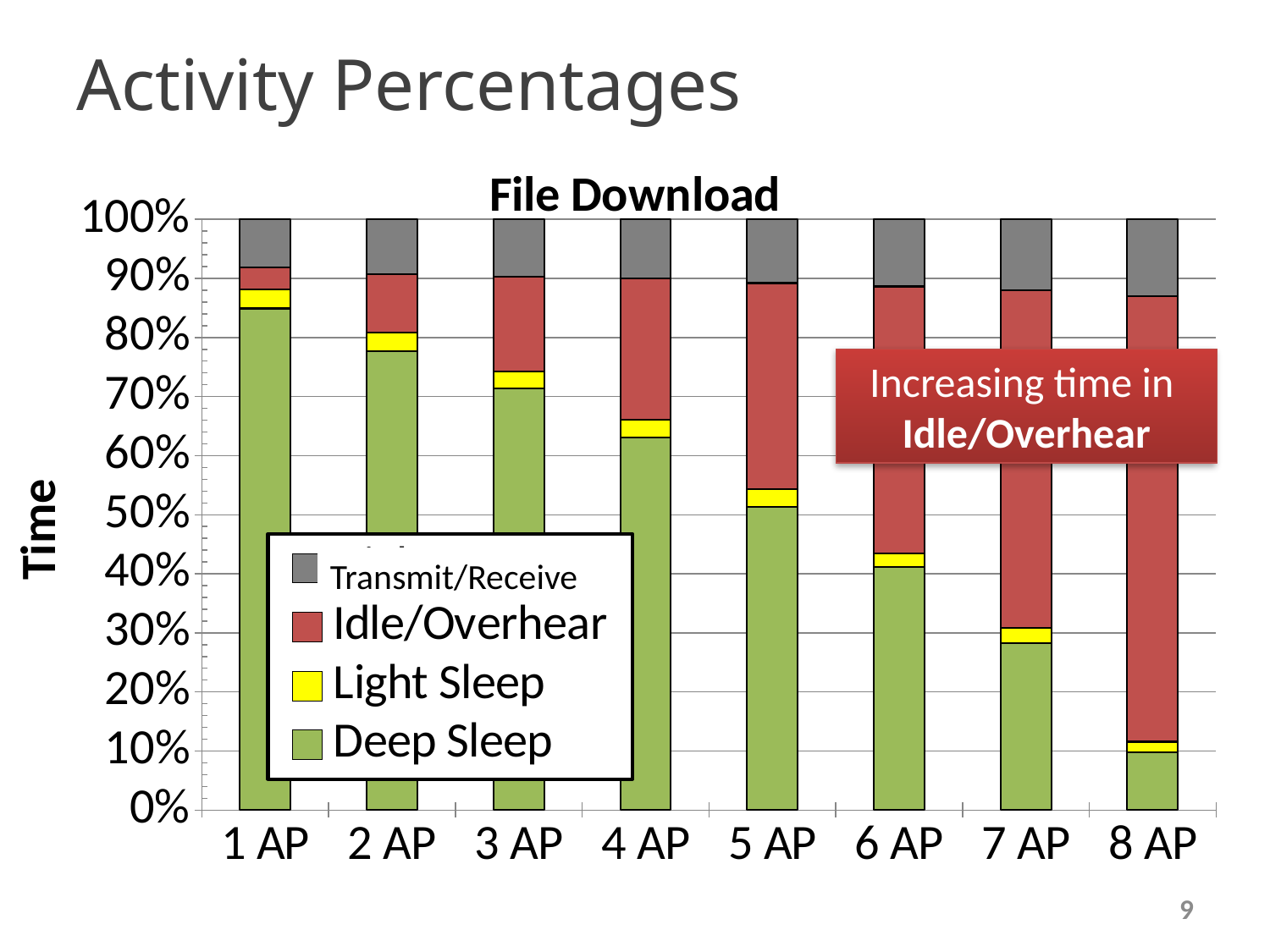
Is the Deep Sleep value for 7 AP greater or less than 40%? less What is the title of the chart on the slide? File Download Which category has the largest Deep Sleep share in the File Download chart? 1 AP What kind of chart is shown on the slide? stacked bar chart Is the Deep Sleep value for 1 AP greater or less than 80%? greater How many categories are shown along the x axis of the File Download chart? 8 Which category has the smallest Deep Sleep share in the File Download chart? 8 AP How many series does the legend of the File Download chart list? 4 Which has a larger Deep Sleep share, 2 AP or 6 AP? 2 AP Is the Deep Sleep value for 8 AP greater or less than 20%? less What is the total height of each stacked bar in the File Download chart? 100% How does the Deep Sleep share change as the number of APs increases from 1 AP to 8 AP? It falls